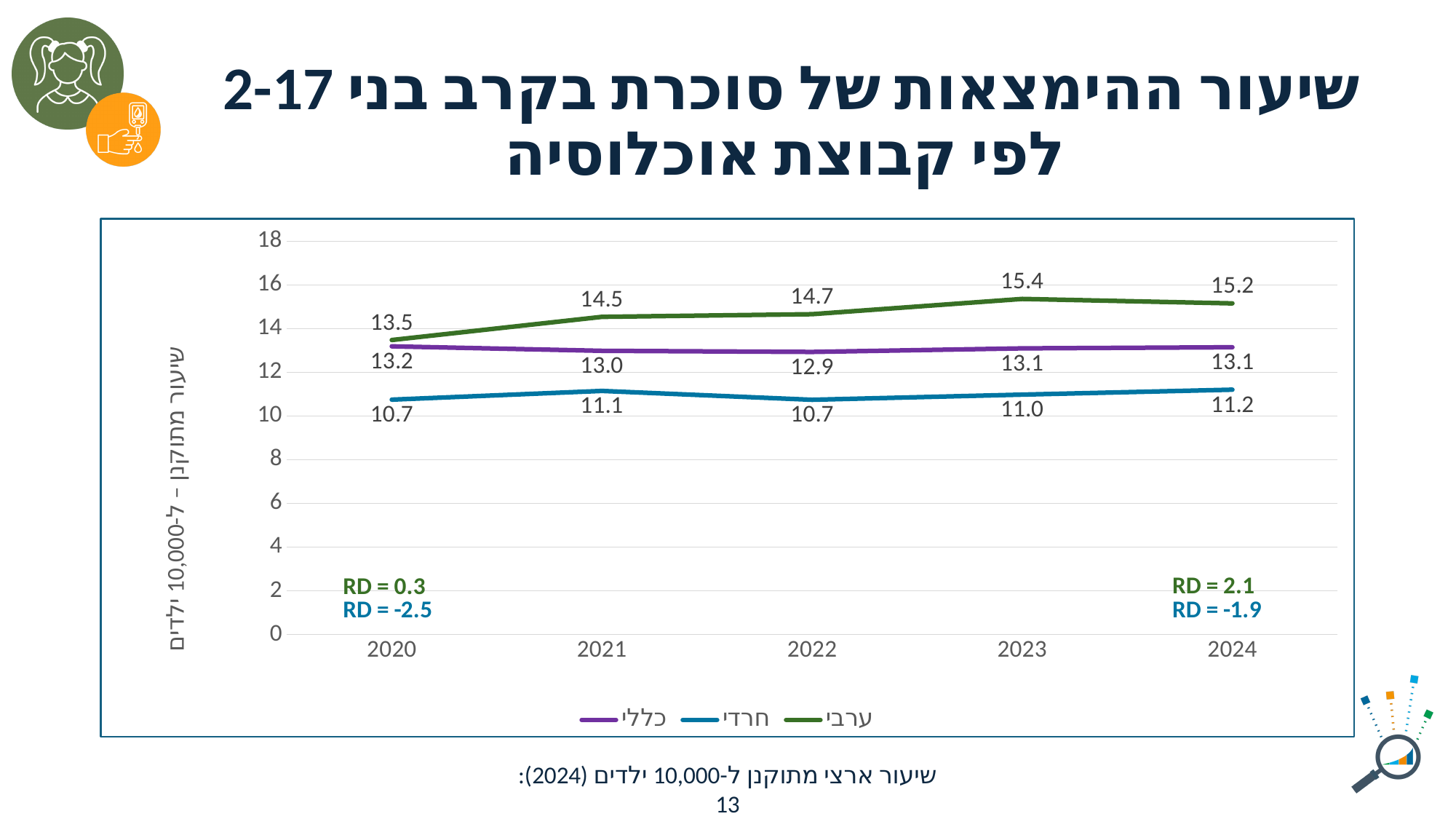
What is the difference between the ערבי and חרדי values in 2024? 4.0 What is the value for the חרדי series in 2020? 10.7 How many years are shown on the x axis? 5 How many series does the legend list? 3 What is the value for the ערבי series in 2023? 15.4 In which year does the ערבי series reach its highest value? 2023 What type of chart is shown on the slide? line chart What is the value for the כללי series in 2022? 12.9 Which series has the larger value in 2021, כללי or חרדי? כללי Which series is drawn in green? ערבי In which year does the כללי series have its lowest value? 2022 Does the ערבי series generally rise or fall from 2020 to 2023? rise